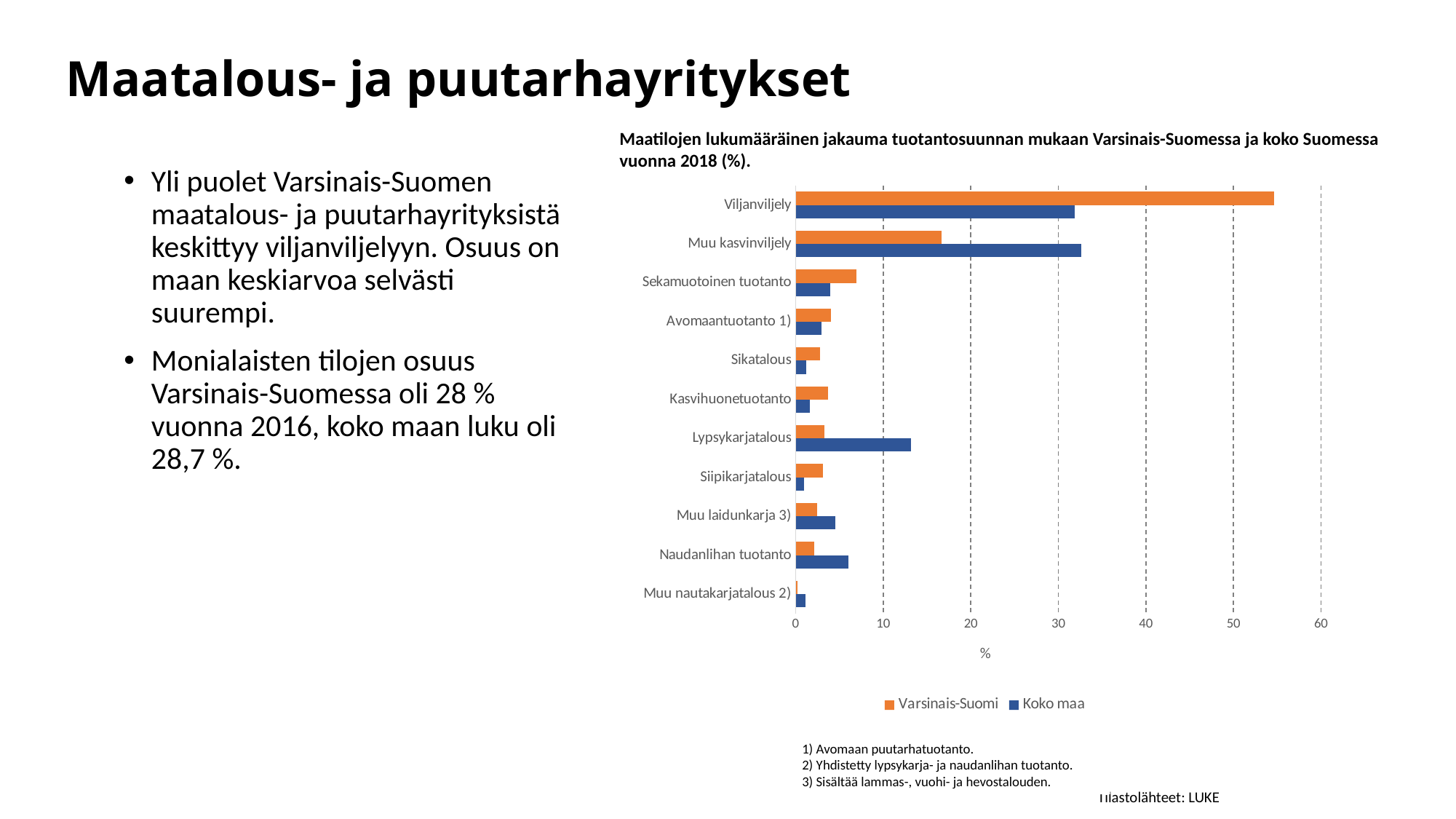
For Sekamuotoinen tuotanto, which series has the larger value, Varsinais-Suomi or Koko maa? Varsinais-Suomi Is the Varsinais-Suomi value for Muu kasvinviljely greater or less than 20? less Is the Koko maa value for Viljanviljely greater or less than 30? greater Is the Koko maa value for Lypsykarjatalous greater or less than 10? greater For Lypsykarjatalous, which series has the larger value, Varsinais-Suomi or Koko maa? Koko maa Which category has the lowest value for Varsinais-Suomi? Muu nautakarjatalous 2) Which colour represents the Varsinais-Suomi series in the chart? orange How many series does the chart legend list? 2 What kind of chart is shown on the slide? bar chart How many categories (production types) are shown on the chart? 11 Which category has the highest value for Varsinais-Suomi? Viljanviljely